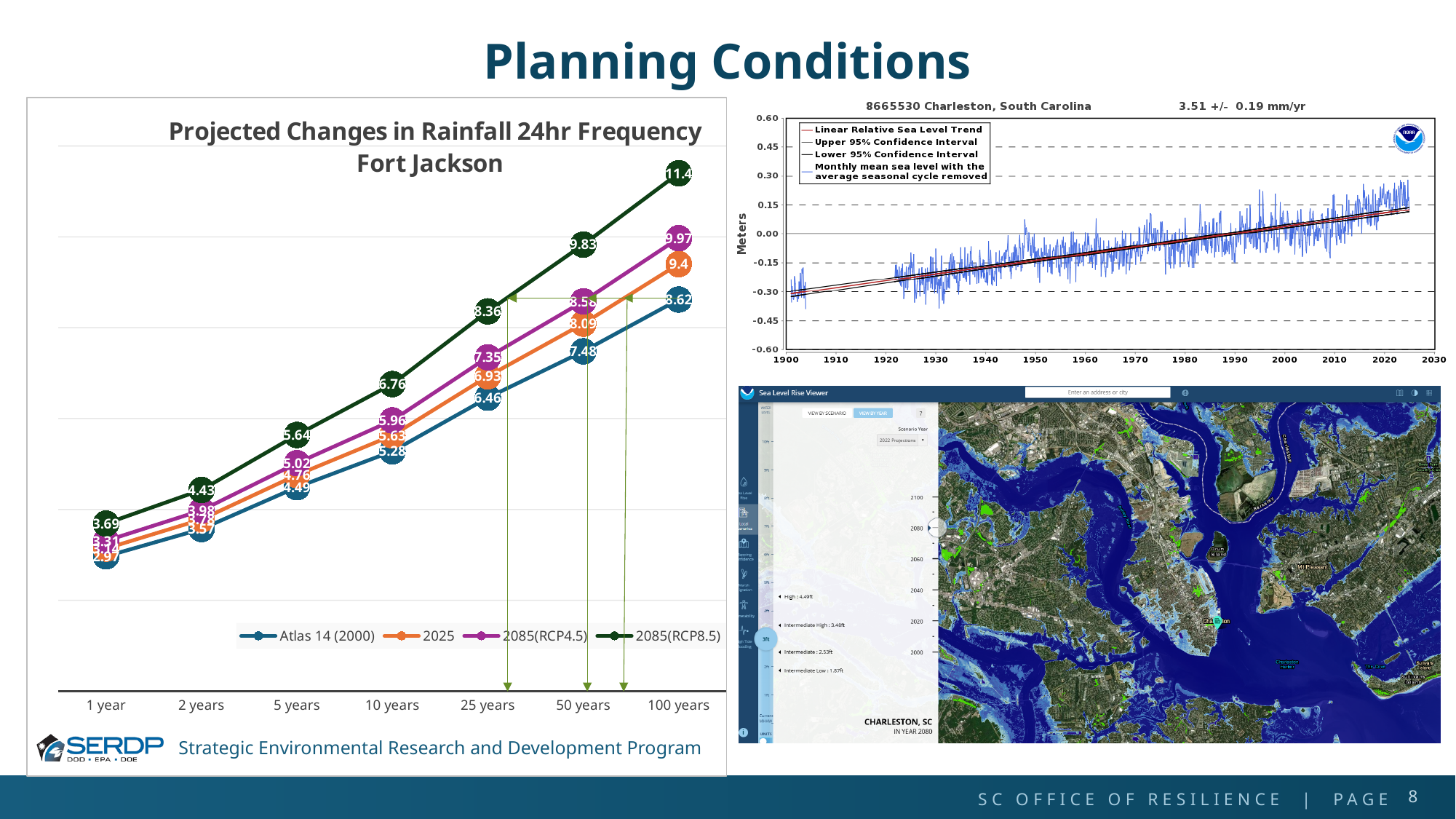
On the 'Projected Changes in Rainfall 24hr Frequency Fort Jackson' chart, what is the value for 2085(RCP4.5) at 10 years? 5.96 On the 'Projected Changes in Rainfall 24hr Frequency Fort Jackson' chart, what is the value for 2025 at 25 years? 6.93 On the 'Projected Changes in Rainfall 24hr Frequency Fort Jackson' chart, what is the value for Atlas 14 (2000) at 50 years? 7.48 On the 'Projected Changes in Rainfall 24hr Frequency Fort Jackson' chart, do the values rise or fall as the return period increases from 1 year to 100 years? rise On the 'Projected Changes in Rainfall 24hr Frequency Fort Jackson' chart, what is the difference between the 2085(RCP8.5) and Atlas 14 (2000) values at 100 years? 2.78 On the 'Projected Changes in Rainfall 24hr Frequency Fort Jackson' chart, which series has the lowest value at 25 years? Atlas 14 (2000) On the 'Projected Changes in Rainfall 24hr Frequency Fort Jackson' chart, how many return-period categories are shown on the x axis? 7 On the 'Projected Changes in Rainfall 24hr Frequency Fort Jackson' chart, which series has the highest value at 100 years? 2085(RCP8.5) On the 'Projected Changes in Rainfall 24hr Frequency Fort Jackson' chart, what is the value for 2085(RCP8.5) at 100 years? 11.4 On the 'Projected Changes in Rainfall 24hr Frequency Fort Jackson' chart, how many series does the legend list? 4 On the 'Projected Changes in Rainfall 24hr Frequency Fort Jackson' chart, which is larger at 50 years: 2025 or 2085(RCP4.5)? 2085(RCP4.5) On the Charleston, South Carolina sea level chart at the top right, what is the linear relative sea level trend stated in the title? 3.51 +/- 0.19 mm/yr